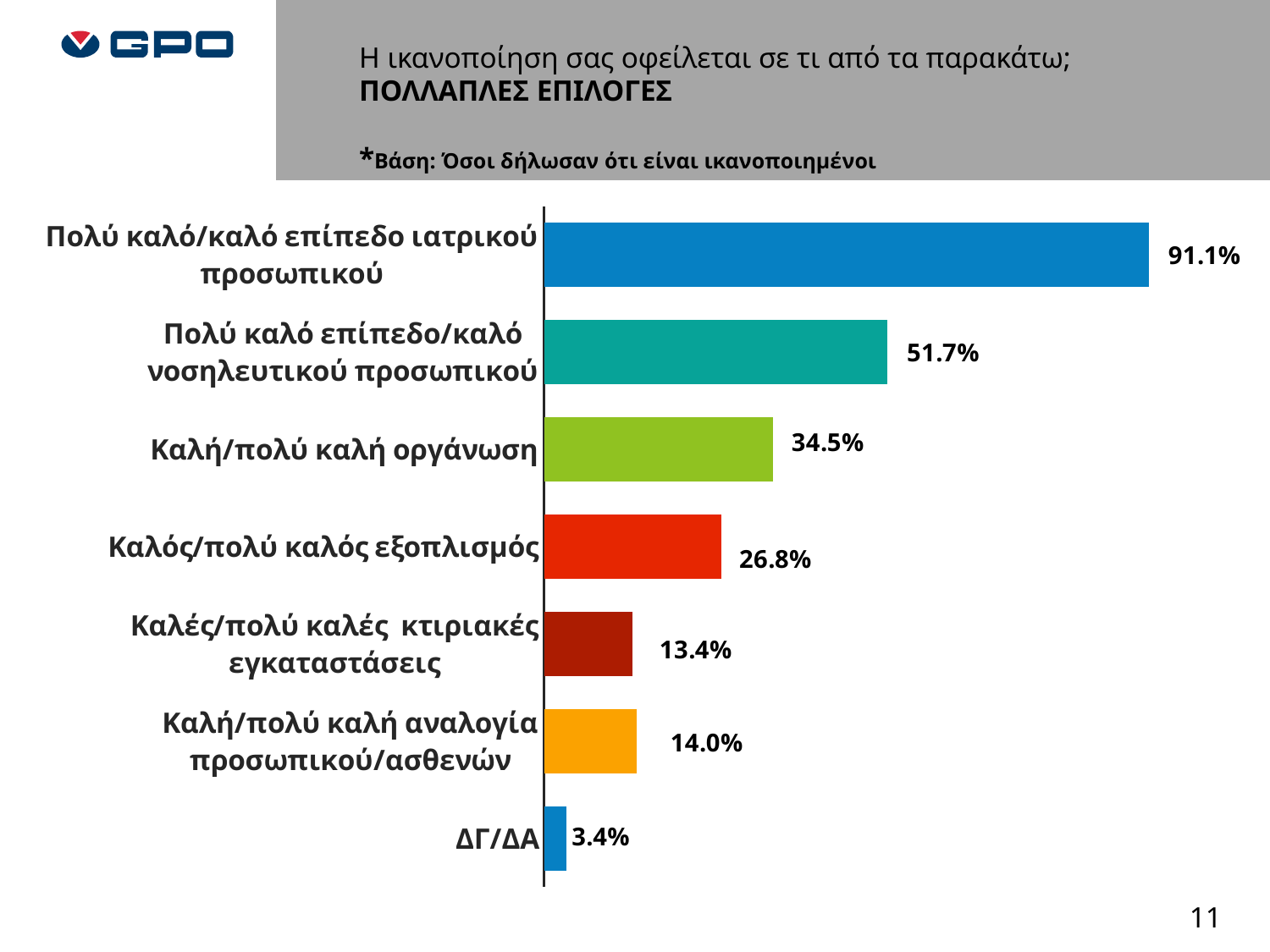
What kind of chart is shown on the slide? Bar chart Which category has the highest value? Πολύ καλό/καλό επίπεδο ιατρικού προσωπικού What is the difference between the values for "Πολύ καλό/καλό επίπεδο ιατρικού προσωπικού" and "Πολύ καλό επίπεδο/καλό νοσηλευτικού προσωπικού"? 39.4% What is the value for "ΔΓ/ΔΑ"? 3.4% What is the value for "Καλή/πολύ καλή οργάνωση"? 34.5% Which category has the lowest value? ΔΓ/ΔΑ What is the value for "Πολύ καλό/καλό επίπεδο ιατρικού προσωπικού"? 91.1% How many categories are shown in the chart? 7 What colour is the bar for "Καλή/πολύ καλή αναλογία προσωπικού/ασθενών"? Orange What is the difference between the values for "Καλή/πολύ καλή αναλογία προσωπικού/ασθενών" and "Καλές/πολύ καλές κτιριακές εγκαταστάσεις"? 0.6% What is the value for "Καλή/πολύ καλή αναλογία προσωπικού/ασθενών"? 14.0% Which is larger, the value for "Καλή/πολύ καλή οργάνωση" or the value for "Καλός/πολύ καλός εξοπλισμός"? Καλή/πολύ καλή οργάνωση